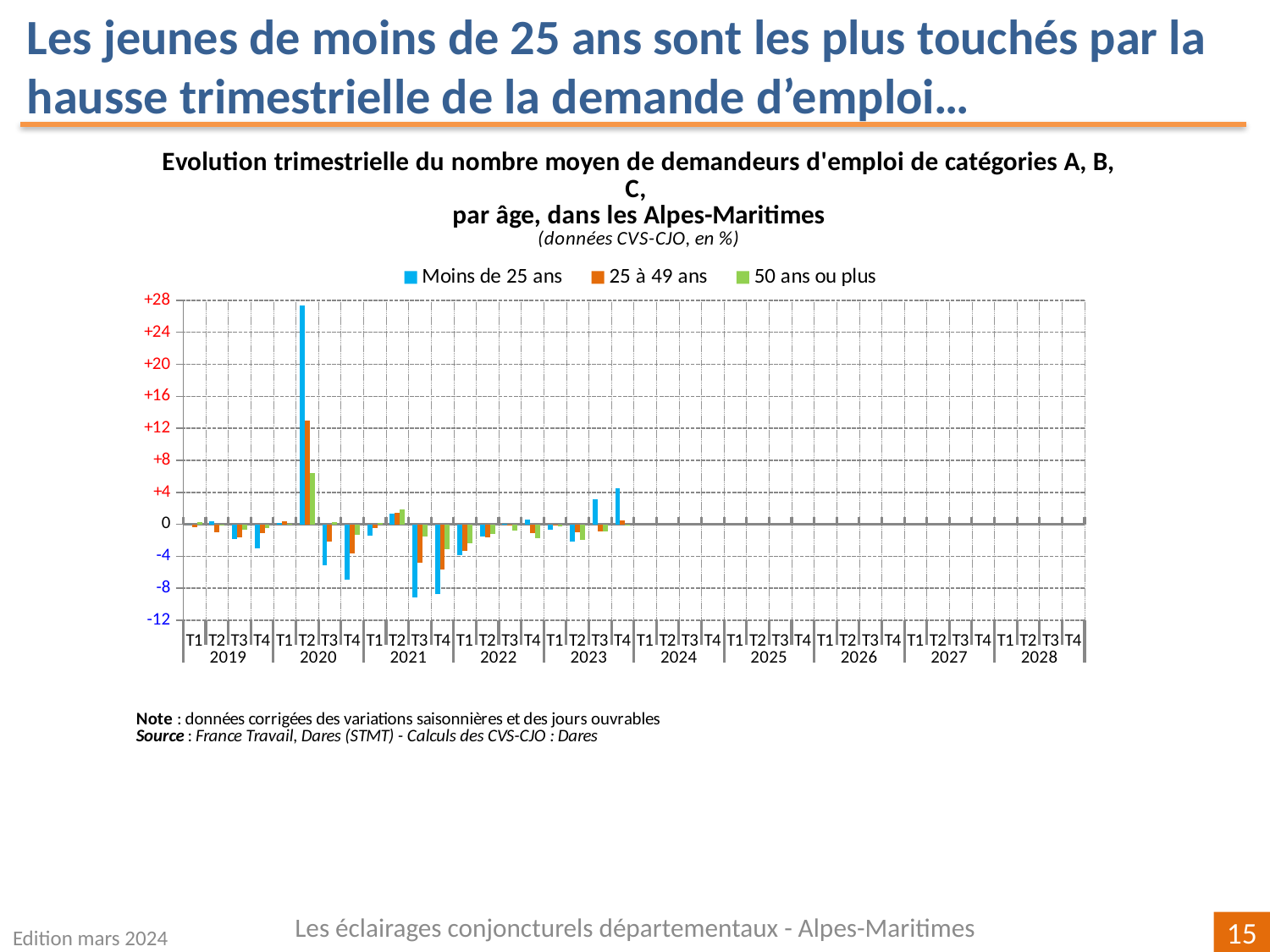
Is the value for 25 à 49 ans in T2 2020 greater or less than +8? greater How many series does the legend list? 3 How many years are labelled along the x axis? 10 Which series has the highest bar in T2 2020? Moins de 25 ans Is the value for Moins de 25 ans in T2 2020 greater or less than +24? greater What is the last year for which bars are plotted on the chart? 2023 Which series are listed in the legend? Moins de 25 ans, 25 à 49 ans, 50 ans ou plus Is the value for Moins de 25 ans in T3 2021 greater or less than -8? less In T2 2020, which is larger: the value for Moins de 25 ans or the value for 25 à 49 ans? Moins de 25 ans What kind of chart is shown on the slide? Bar chart In which quarter does the tallest bar of the chart appear? T2 2020